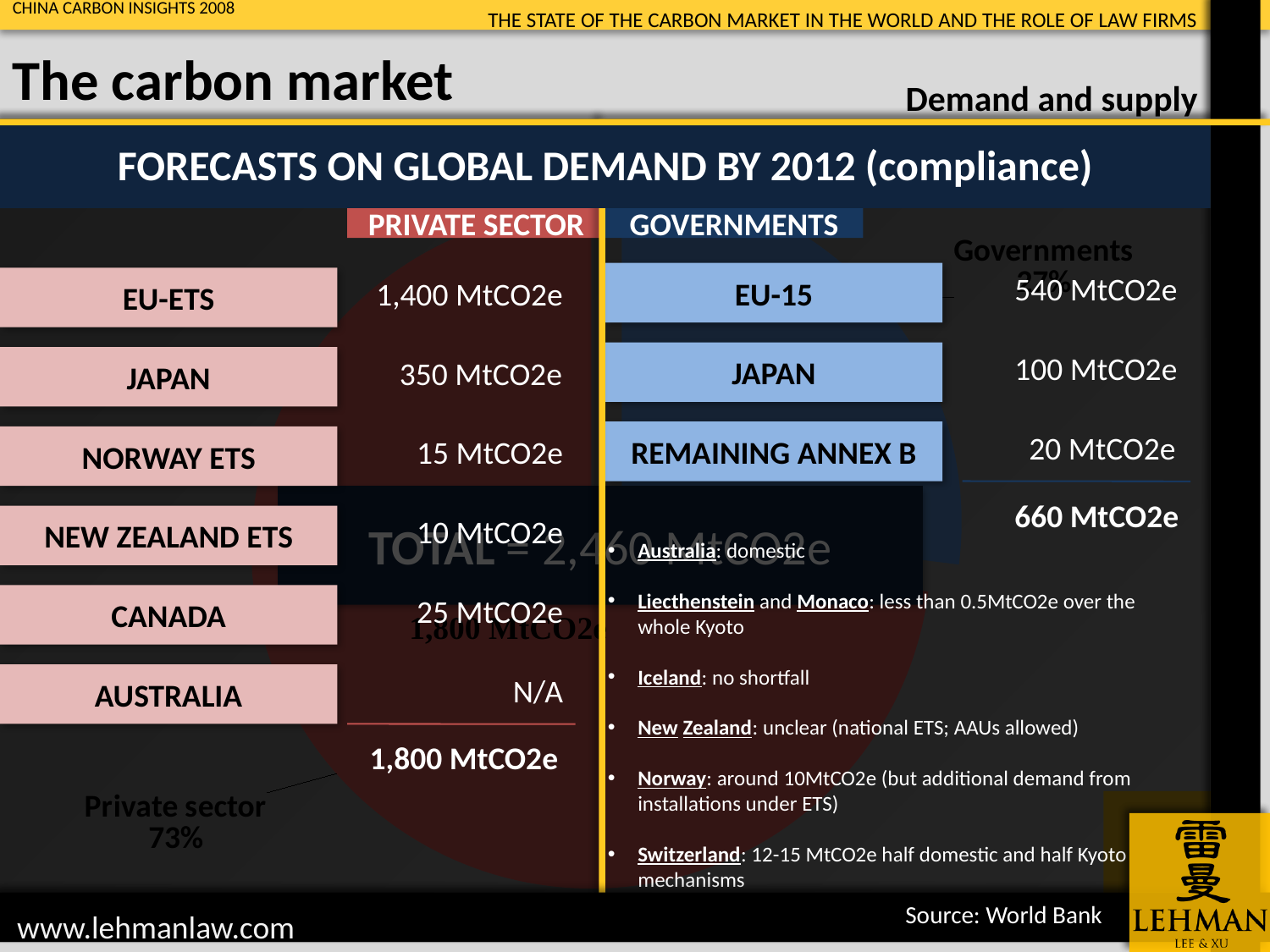
Which is larger in the pie chart, the Private sector slice or the Governments slice? Private sector Which slice of the pie chart is the smallest? Governments What share of the pie chart does the Private sector slice represent? 73% How many slices does the pie chart have? 2 What colour is the Private sector slice of the pie chart? dark red Is the Private sector share of the pie chart greater or less than 50%? greater Which slice of the pie chart is the largest? Private sector What colour is the Governments slice of the pie chart? dark blue What kind of chart is shown in the background of the slide? pie chart